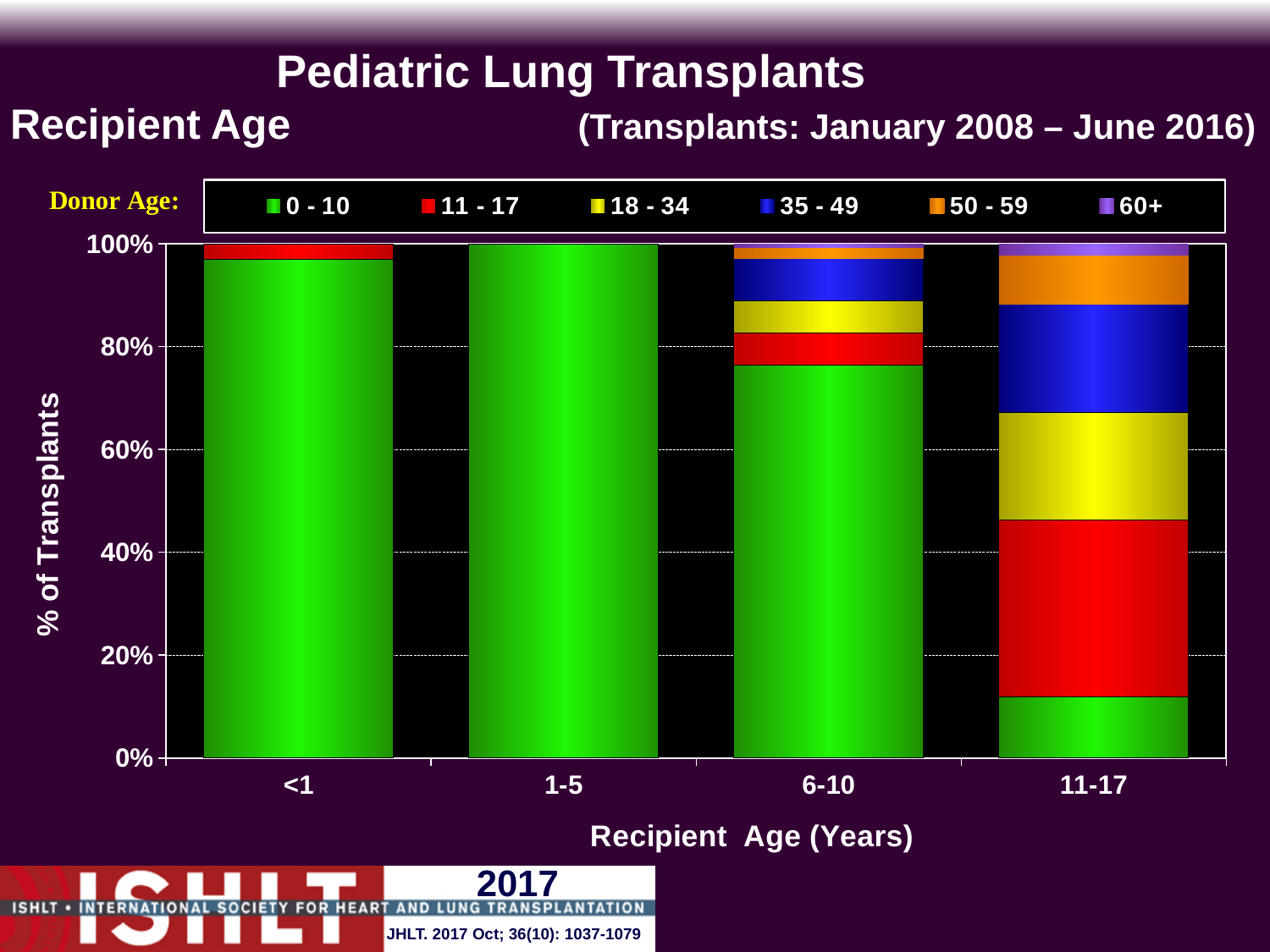
What is the title of the y axis? % of Transplants Is the share of transplants from donors aged 0 - 10 for recipients aged 11-17 greater or less than 20%? less What kind of chart is shown on the slide? Stacked bar chart Which recipient age group has the smallest share of transplants from donors aged 0 - 10? 11-17 How many donor age series does the legend list? 6 Is the share of transplants from donors aged 0 - 10 for recipients aged 6-10 greater or less than 60%? greater Is the share of transplants from donors aged 11 - 17 for recipients aged 11-17 greater or less than 20%? greater What does the legend on the chart represent? Donor Age How many recipient age categories are shown on the x axis? 4 Which recipient age group has a larger share of transplants from donors aged 0 - 10: 1-5 or 11-17? 1-5 Which recipient age group has a larger share of transplants from donors aged 35 - 49: 6-10 or 11-17? 11-17 What is the total height of the stacked bar for recipients aged 11-17? 100%